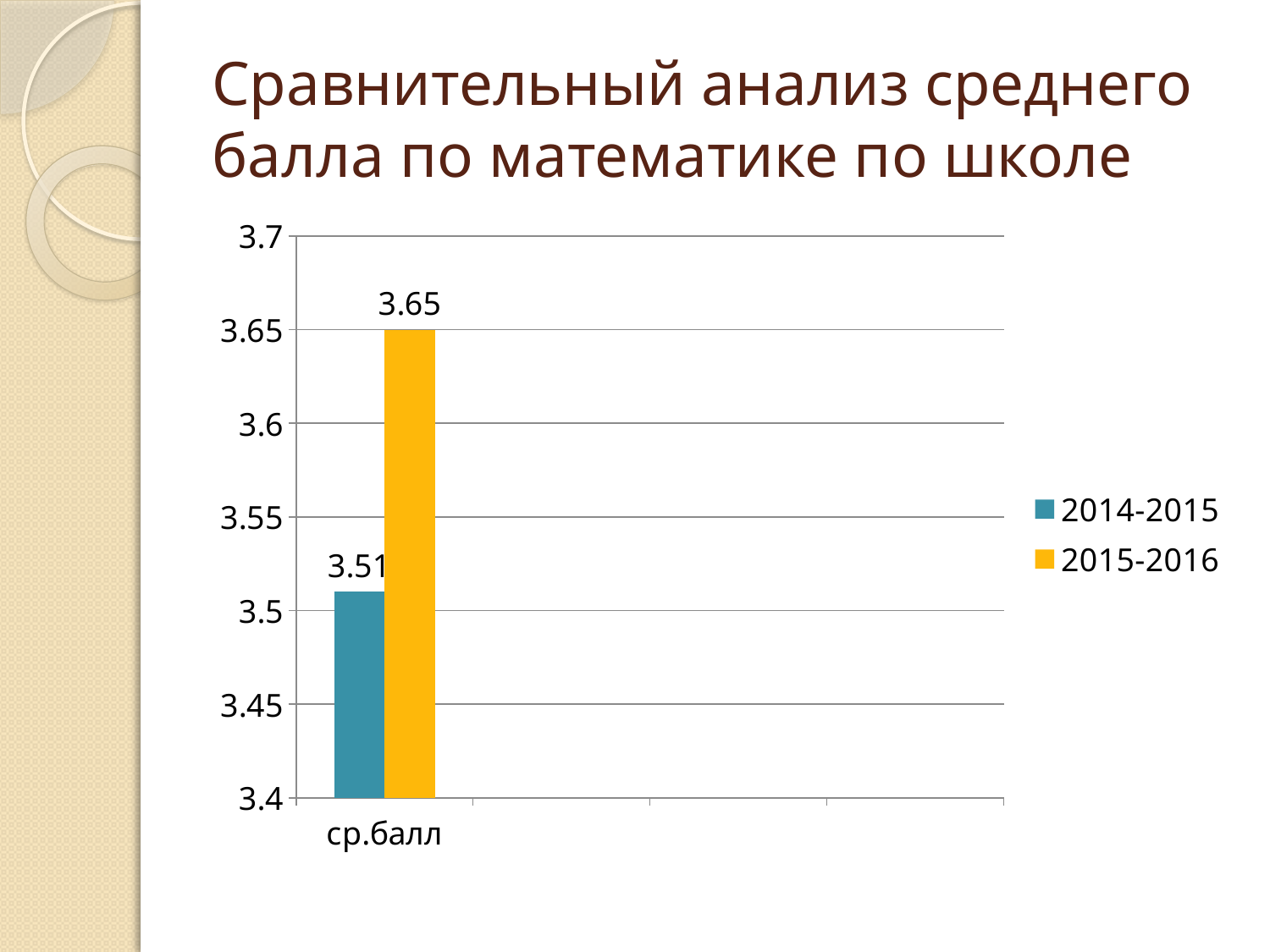
What kind of chart is shown on the slide? bar chart What is the difference between the 2015-2016 value and the 2014-2015 value? 0.14 How many series does the legend list? 2 What is the value for 2015-2016 in the chart? 3.65 What is the label of the category on the x axis? ср.балл What is the value for 2014-2015 in the chart? 3.51 Is the value for 2014-2015 greater or less than 3.55? less Which series has the lowest value in the chart? 2014-2015 Which series has the highest value in the chart? 2015-2016 Which series has the higher value, 2014-2015 or 2015-2016? 2015-2016 Is the value for 2015-2016 greater or less than 3.6? greater How many categories are shown on the x axis? 1